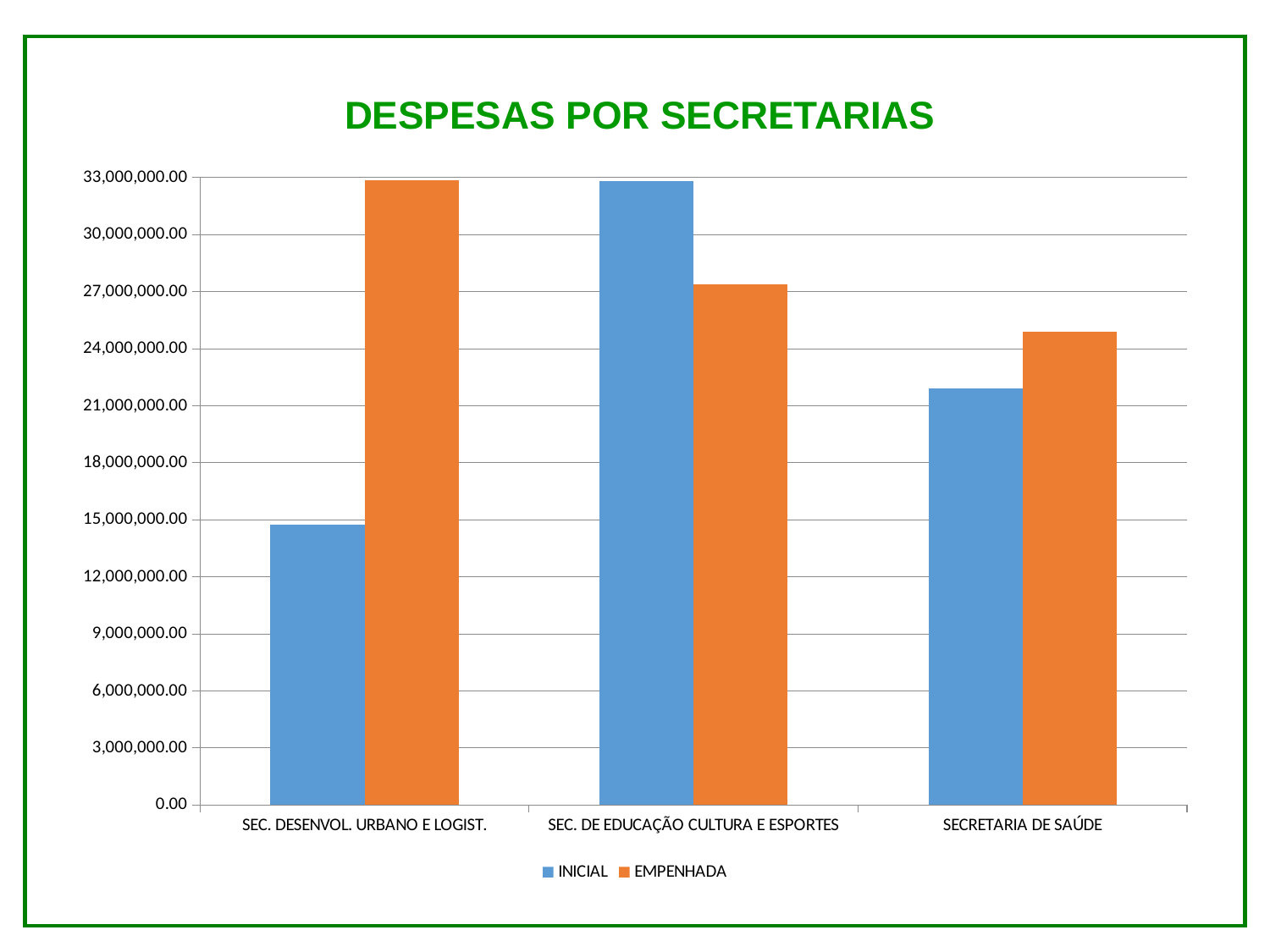
Which secretaria has the lowest INICIAL value? SEC. DESENVOL. URBANO E LOGIST. Is the INICIAL value for SEC. DESENVOL. URBANO E LOGIST. greater or less than 18,000,000.00? less For SEC. DE EDUCAÇÃO CULTURA E ESPORTES, which is larger, INICIAL or EMPENHADA? INICIAL Is the EMPENHADA value for SECRETARIA DE SAÚDE greater or less than 24,000,000.00? greater How many secretarias (categories) are shown on the x axis? 3 Which secretaria has the highest EMPENHADA value? SEC. DESENVOL. URBANO E LOGIST. How many series does the legend list? 2 What kind of chart is shown on the slide? bar chart Which secretaria has the lowest EMPENHADA value? SECRETARIA DE SAÚDE What is the title of the chart? DESPESAS POR SECRETARIAS Which secretaria has the highest INICIAL value? SEC. DE EDUCAÇÃO CULTURA E ESPORTES For SEC. DESENVOL. URBANO E LOGIST., which is larger, INICIAL or EMPENHADA? EMPENHADA